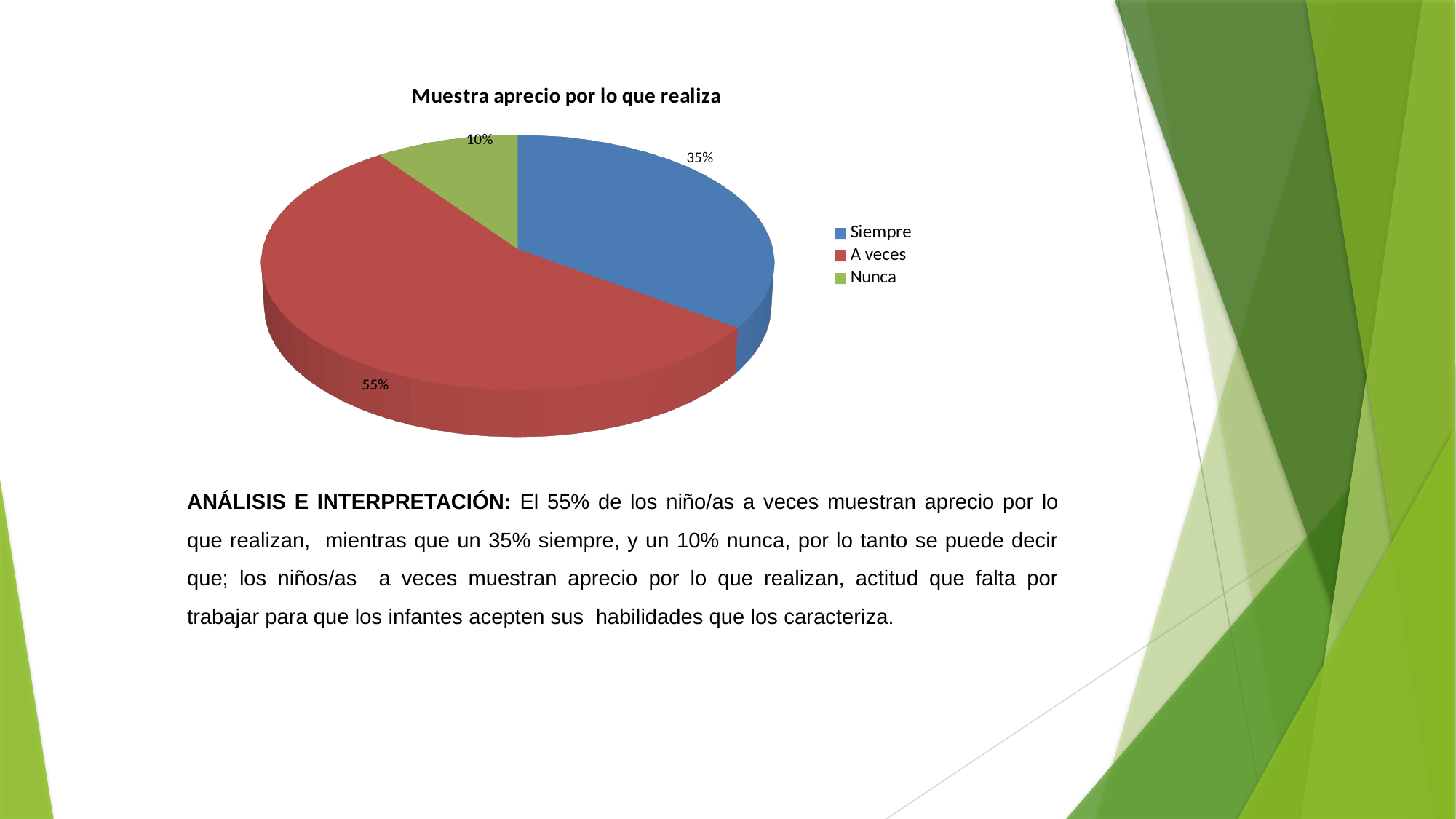
What is the title of the chart? Muestra aprecio por lo que realiza How many categories does the legend list? 3 Which category has the largest share of the pie? A veces What percentage of the pie does the 'A veces' slice represent? 55% What is the difference in percentage points between the 'Siempre' and 'Nunca' slices? 25 Which category has the smallest share of the pie? Nunca What type of chart is shown on the slide? Pie chart What colour is the 'A veces' slice? Red What is the difference in percentage points between the 'A veces' and 'Siempre' slices? 20 Which slice is larger, 'Siempre' or 'Nunca'? Siempre What percentage of the pie does the 'Nunca' slice represent? 10% What percentage of the pie does the 'Siempre' slice represent? 35%